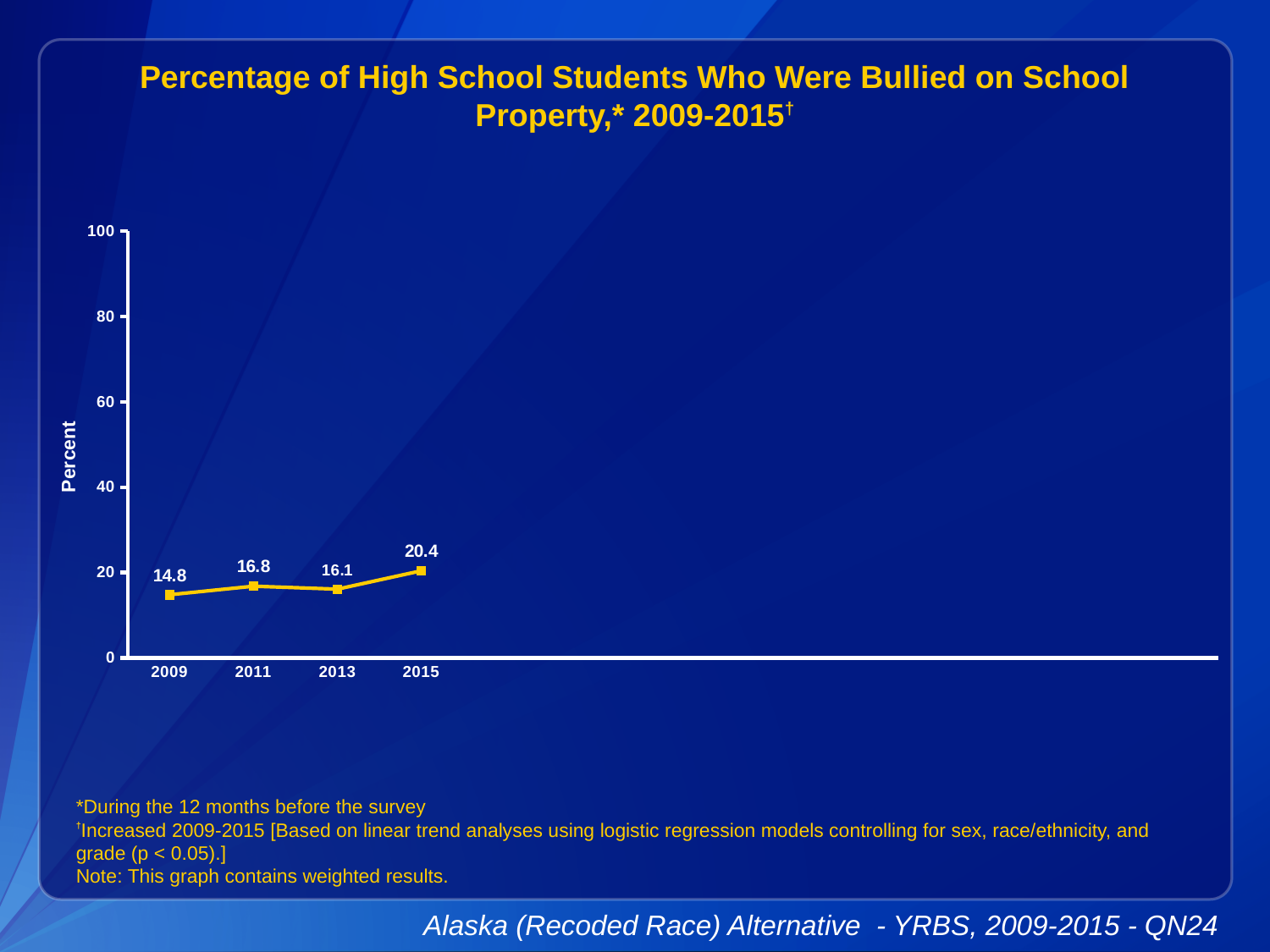
What is the difference between the 2015 value and the 2009 value? 5.6 How many years are plotted on the x axis? 4 What is the value plotted for 2015? 20.4 What is the value plotted for 2013? 16.1 Which year has the lowest percentage of students bullied on school property? 2009 Which year has the larger value, 2011 or 2013? 2011 Which year has the highest percentage of students bullied on school property? 2015 Is the value for 2015 greater or less than 40? less What percentage of high school students were bullied on school property in 2009? 14.8 What is the label on the y axis? Percent Overall, do the values rise or fall from 2009 to 2015? rise What kind of chart is shown on the slide? line chart